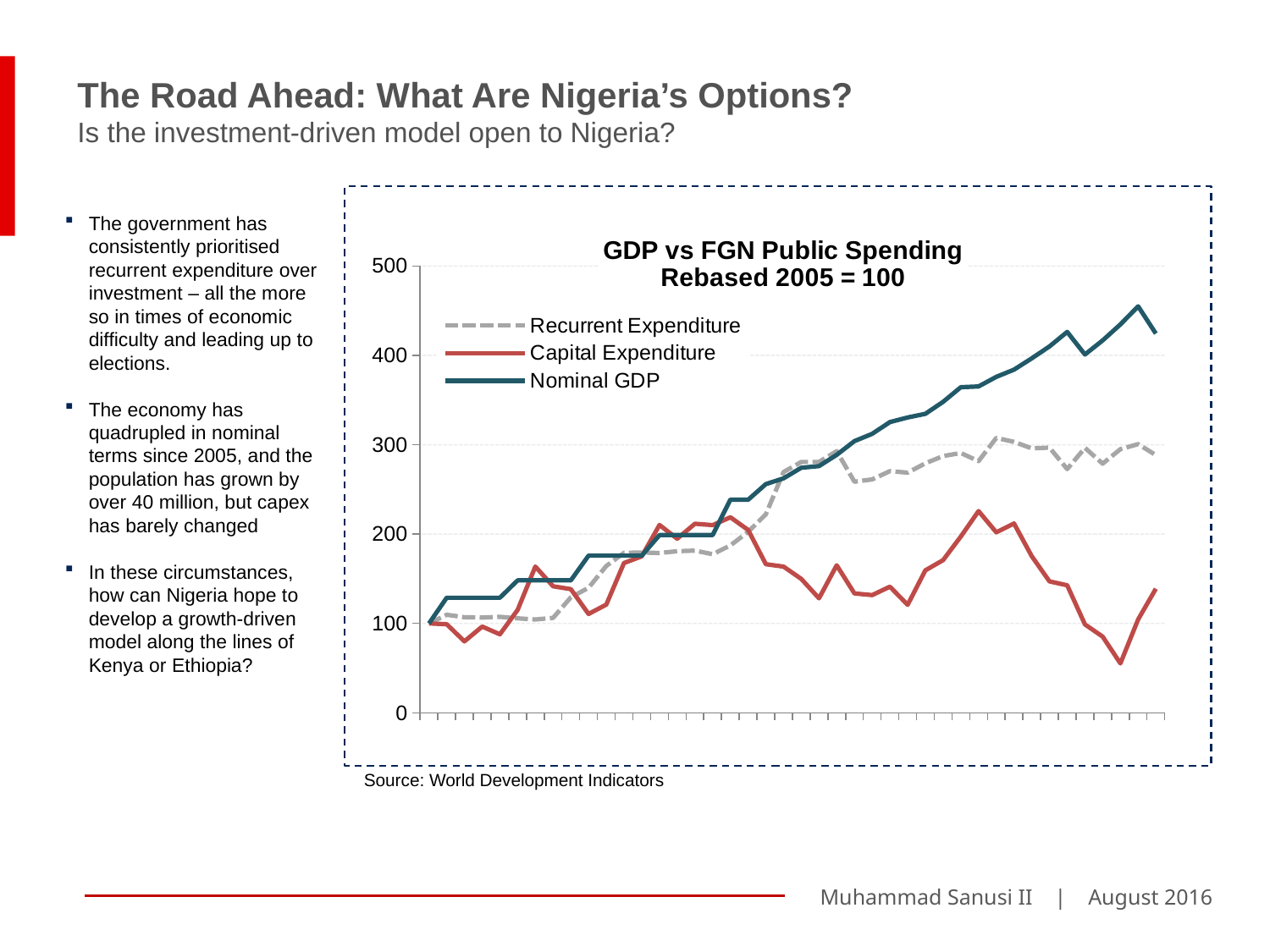
Which series reaches the highest value on the chart? Nominal GDP Which series is drawn as a dashed grey line? Recurrent Expenditure What is the title of the chart? GDP vs FGN Public Spending Rebased 2005 = 100 At the right-hand end of the chart, which is larger: Recurrent Expenditure or Capital Expenditure? Recurrent Expenditure Is the lowest point of the Capital Expenditure series greater or less than 100? less Which series ends at the lowest value at the right-hand end of the chart? Capital Expenditure Does the Nominal GDP series generally rise or fall along the x axis? Rise How many series does the chart's legend list? 3 What kind of chart is shown on the slide? Line chart Is the final value of the Capital Expenditure series greater or less than 200? less Is the final value of the Nominal GDP series greater or less than 400? greater What is the rebased index value for 2005 according to the chart title? 100